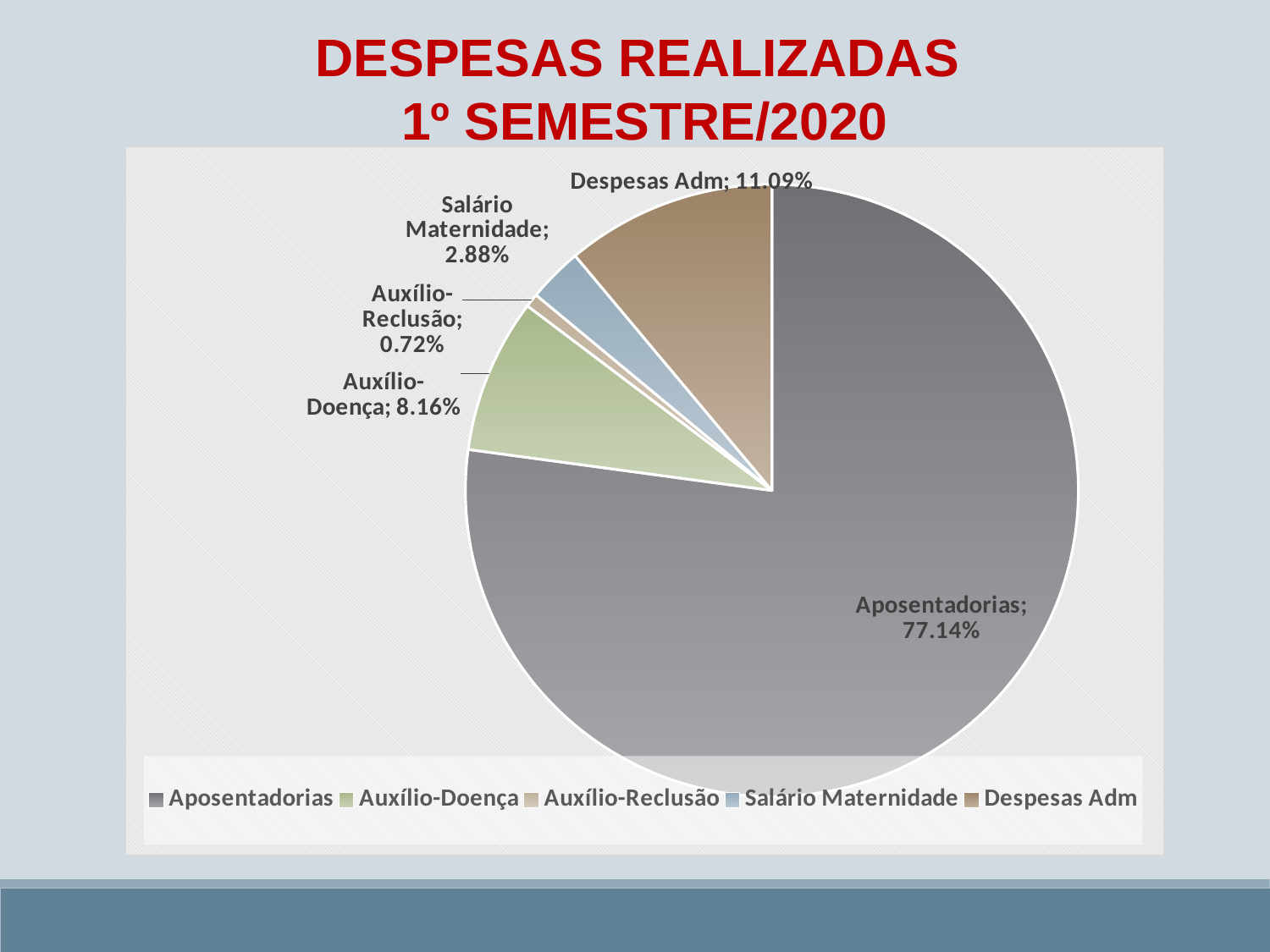
What share of expenses is Aposentadorias? 77.14% What share of expenses is Auxílio-Reclusão? 0.72% What share of expenses is Salário Maternidade? 2.88% What share of expenses is Auxílio-Doença? 8.16% What type of chart is shown on the slide? pie chart Which is larger, Despesas Adm or Auxílio-Doença? Despesas Adm Which category has the largest share of the pie? Aposentadorias Which category has the smallest share of the pie? Auxílio-Reclusão How many categories does the pie chart have? 5 What is the difference in percentage points between Despesas Adm and Auxílio-Doença? 2.93 What share of expenses is Despesas Adm? 11.09% What is the title of the slide? DESPESAS REALIZADAS 1º SEMESTRE/2020